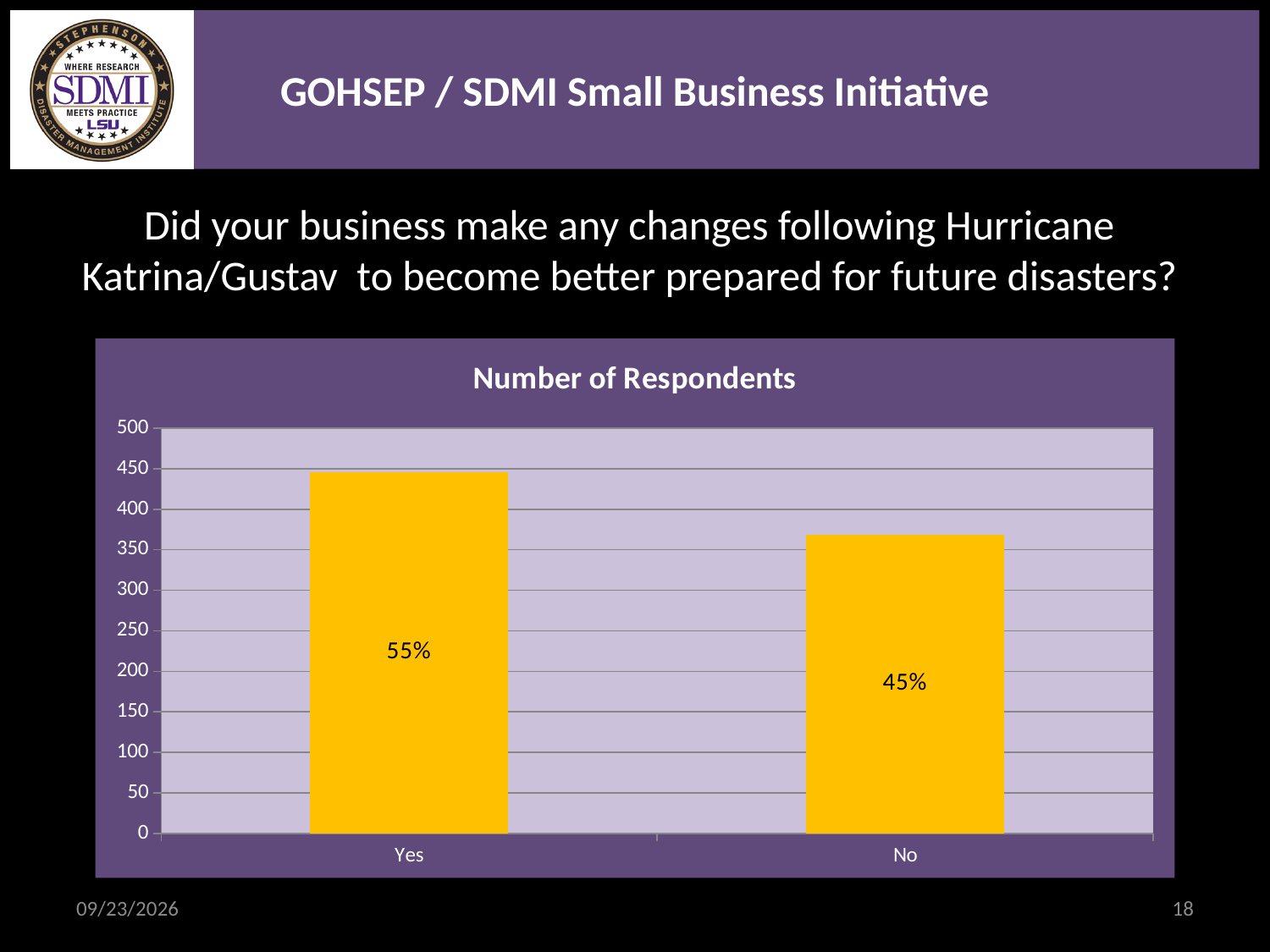
Which category has the lowest number of respondents? No Is the number of respondents for Yes greater or less than 400? greater What percentage label is shown on the Yes bar? 55% What is the difference in percentage points between the Yes and No labels? 10 percentage points Is the number of respondents for No greater or less than 300? greater Is the number of respondents for No greater or less than 400? less Which bar is taller, Yes or No? Yes How many categories are shown on the x axis of the chart? 2 What percentage label is shown on the No bar? 45% What is the title of the chart? Number of Respondents What kind of chart is shown on the slide? bar chart Which category has the highest number of respondents? Yes